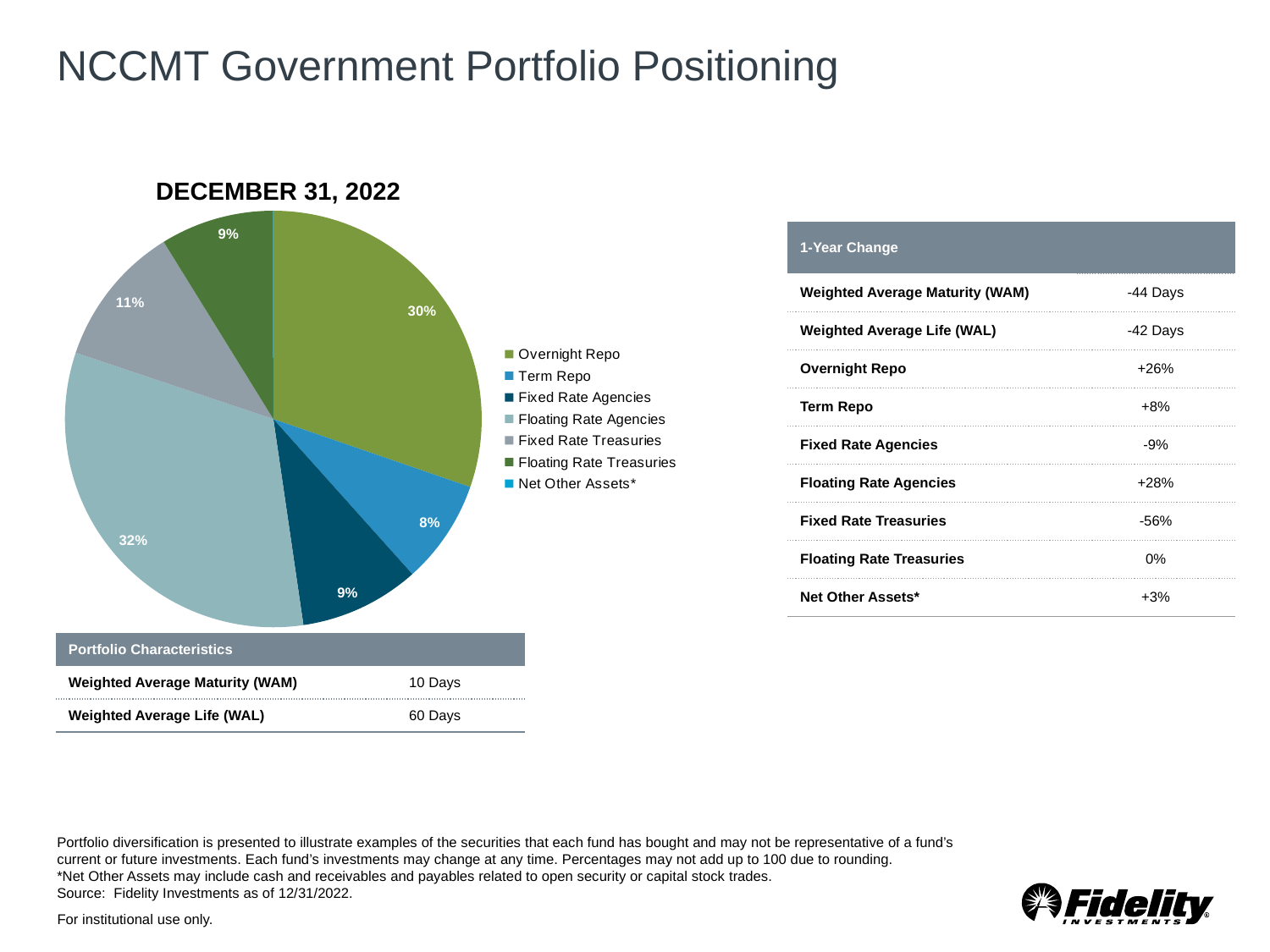
What is the value shown for Fixed Rate Agencies in the pie chart? 9% What share of the pie does Overnight Repo represent? 30% What is the value shown for Fixed Rate Treasuries in the pie chart? 11% What is the title of the pie chart? DECEMBER 31, 2022 What type of chart is shown on the slide? Pie chart What share of the pie does Floating Rate Agencies represent? 32% What is the value shown for Term Repo in the pie chart? 8% How many categories does the pie chart's legend list? 7 What is the value shown for Floating Rate Treasuries in the pie chart? 9% Which category has the largest slice of the pie? Floating Rate Agencies Which is larger in the pie chart, Overnight Repo or Fixed Rate Treasuries? Overnight Repo What is the difference in percentage points between Floating Rate Agencies and Overnight Repo? 2 percentage points